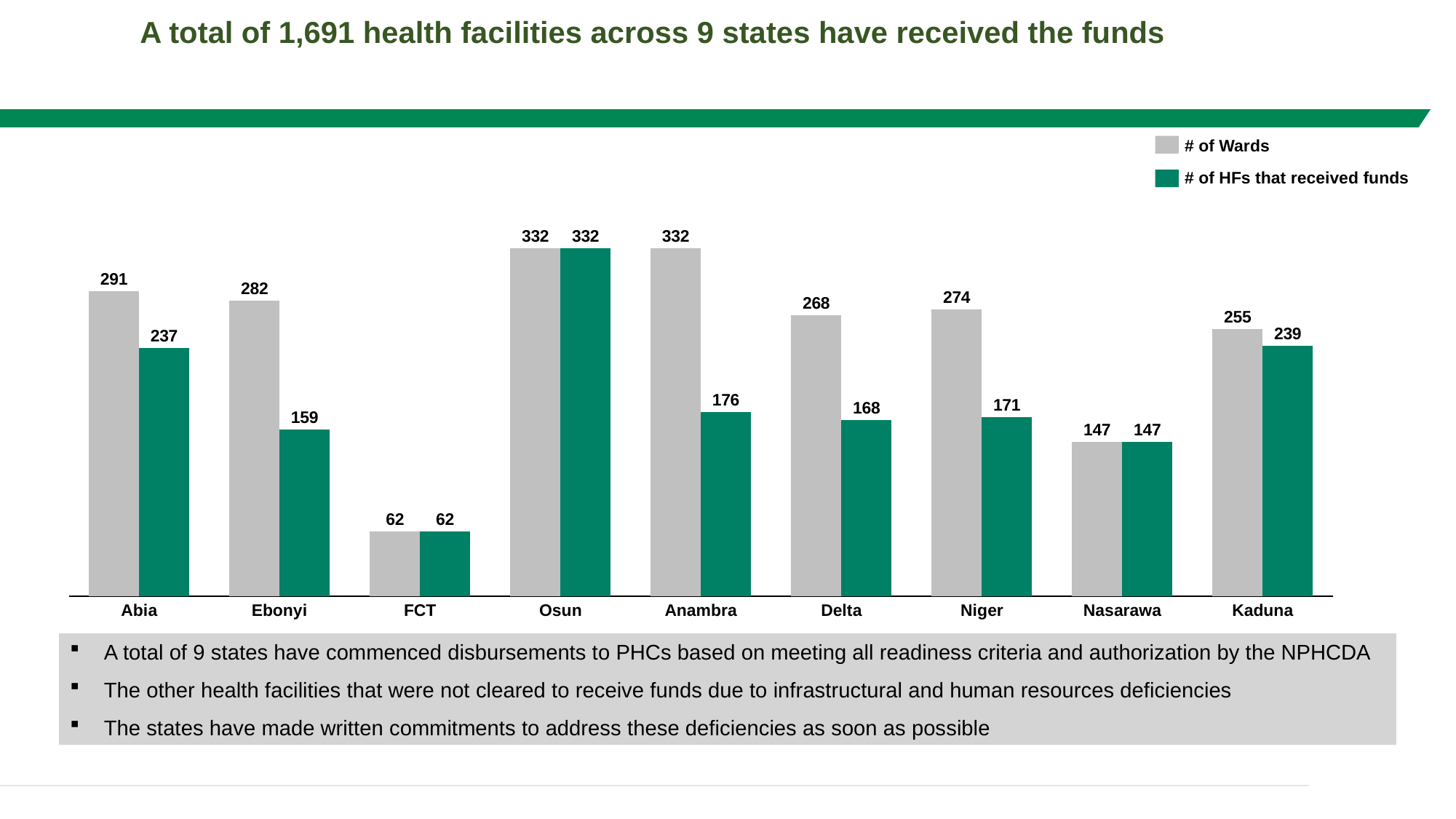
What is the difference between the number of wards and the number of HFs that received funds in Anambra? 156 What is the number of HFs that received funds in Kaduna? 239 How many states are shown on the x axis of the chart? 9 How many series does the legend list? 2 What kind of chart is shown on the slide? Bar chart What is the number of wards for Abia? 291 Which colour represents the number of HFs that received funds in the legend? Green Which state has the lowest number of wards? FCT How many HFs received funds in Ebonyi? 159 Which is larger, the number of HFs that received funds in Abia or in Kaduna? Kaduna What is the difference between the number of wards in Niger and in Delta? 6 Which state has the highest number of HFs that received funds? Osun